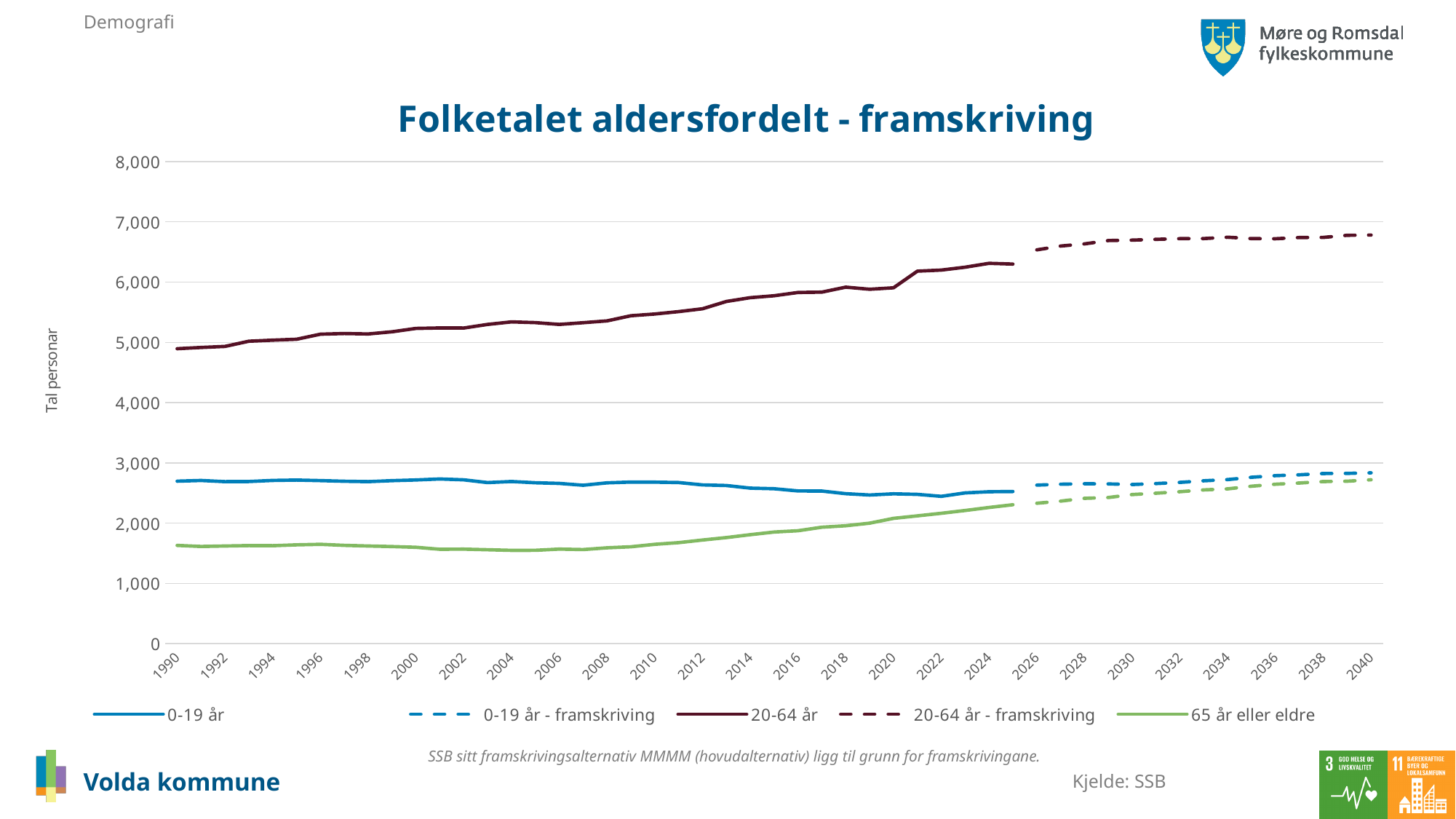
Is the value for 20-64 år in 1990 greater or less than 5,000? less Is the projected value for 20-64 år - framskriving in 2040 greater or less than 7,000? less Which age group has the highest value in 2024? 20-64 år What is the title of the chart? Folketalet aldersfordelt - framskriving What is the label on the vertical axis of the chart? Tal personar Which age group has the lowest value in 1990? 65 år eller eldre Is the value for 65 år eller eldre in 2024 greater or less than 2,000? greater What kind of chart is shown on the slide? line chart Does the 20-64 år line generally rise or fall from 1990 to 2024? rise